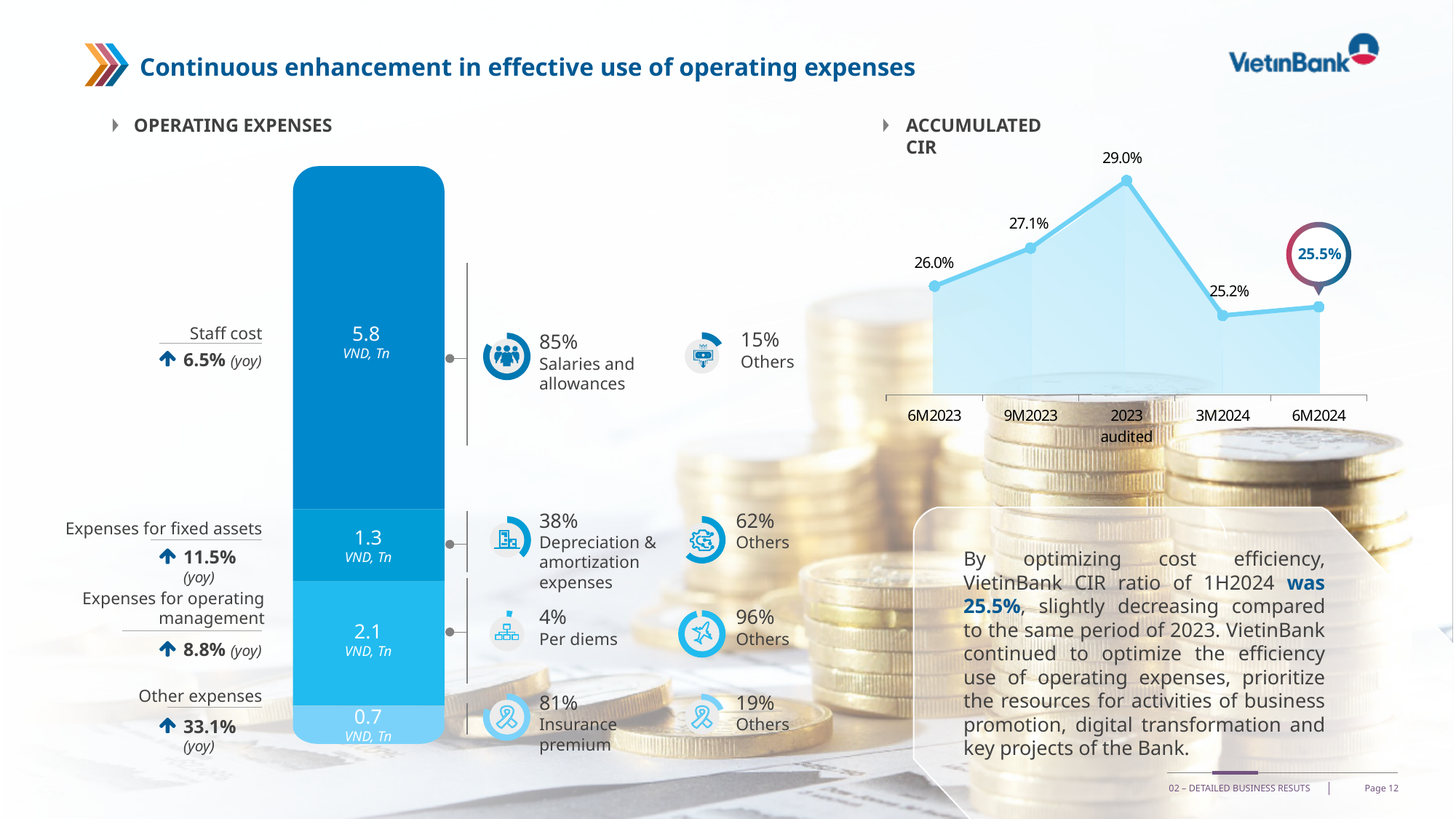
In the Accumulated CIR chart, is the CIR for 9M2023 higher or lower than for 6M2023? higher In the Accumulated CIR chart, what is the value for 6M2024? 25.5% In the Operating Expenses chart, what is the value of the Other expenses segment? 0.7 VND, Tn In the Operating Expenses chart, what is the year-on-year growth shown for Other expenses? 33.1% In the Accumulated CIR chart, which period has the lowest CIR? 3M2024 In the Operating Expenses chart, which segment is the largest? Staff cost In the Accumulated CIR chart, what is the difference between the 2023 audited value and the 6M2024 value? 3.5% In the Accumulated CIR chart, what is the value for 2023 audited? 29.0% In the Operating Expenses chart, what is the total of all four segments of the stacked bar? 9.9 VND, Tn In the Operating Expenses chart, what is the value of the Staff cost segment? 5.8 VND, Tn In the Accumulated CIR chart, which period has the highest CIR? 2023 audited In the Accumulated CIR chart, how many periods are plotted? 5